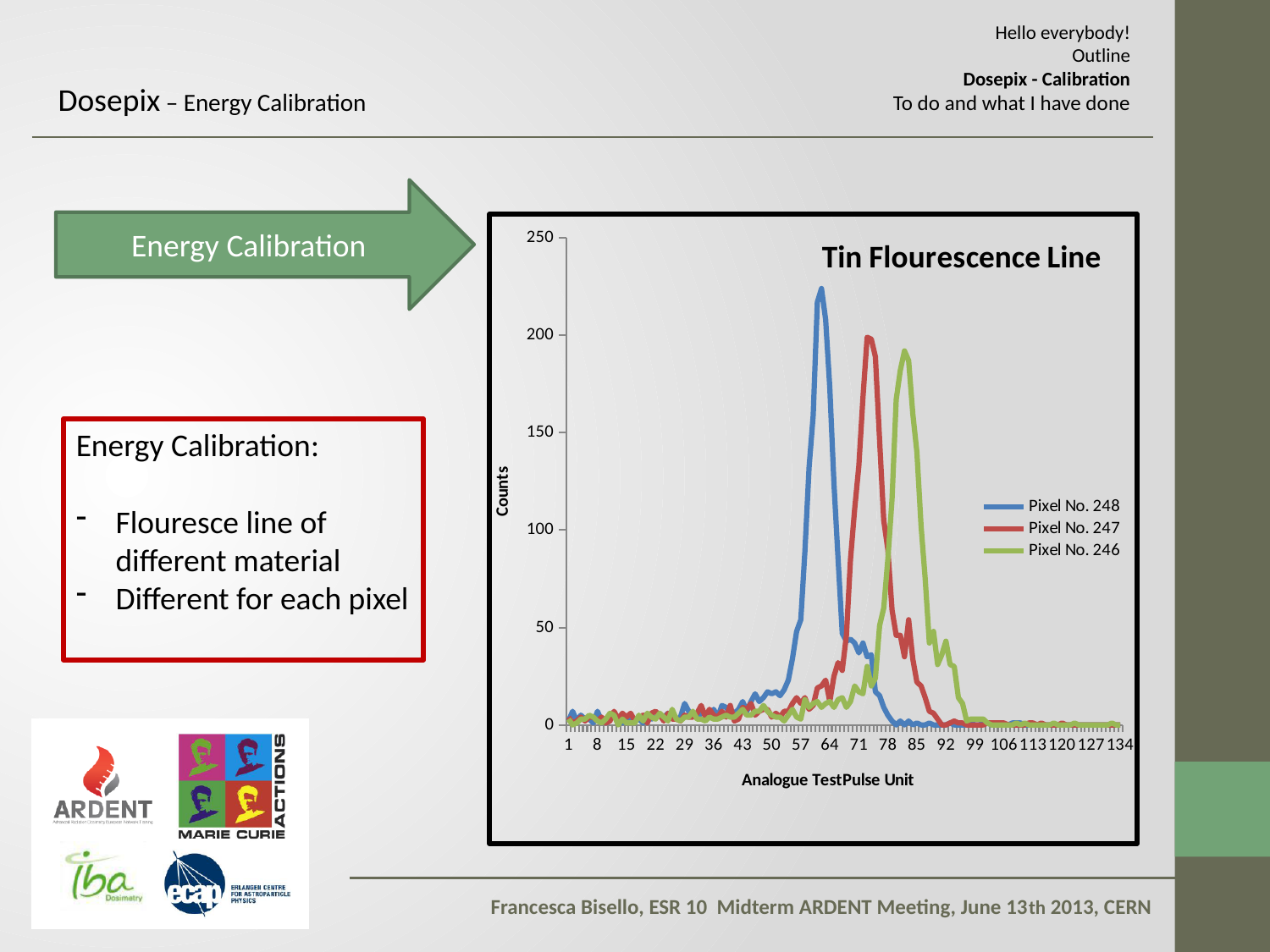
Is the peak value for Pixel No. 246 greater or less than 150? greater What is the maximum value shown on the Counts axis? 250 Which series reaches the highest peak in counts? Pixel No. 248 Which series has its peak at the lowest Analogue TestPulse Unit value? Pixel No. 248 How many series does the chart's legend list? 3 Which series has its peak at the highest Analogue TestPulse Unit value? Pixel No. 246 What is the title of the chart? Tin Flourescence Line What is the label of the x axis of the chart? Analogue TestPulse Unit What kind of chart is shown on the slide? line chart Is the peak value for Pixel No. 248 greater or less than 200? greater Which has the higher peak, Pixel No. 248 or Pixel No. 246? Pixel No. 248 Is the peak value for Pixel No. 247 greater or less than 150? greater